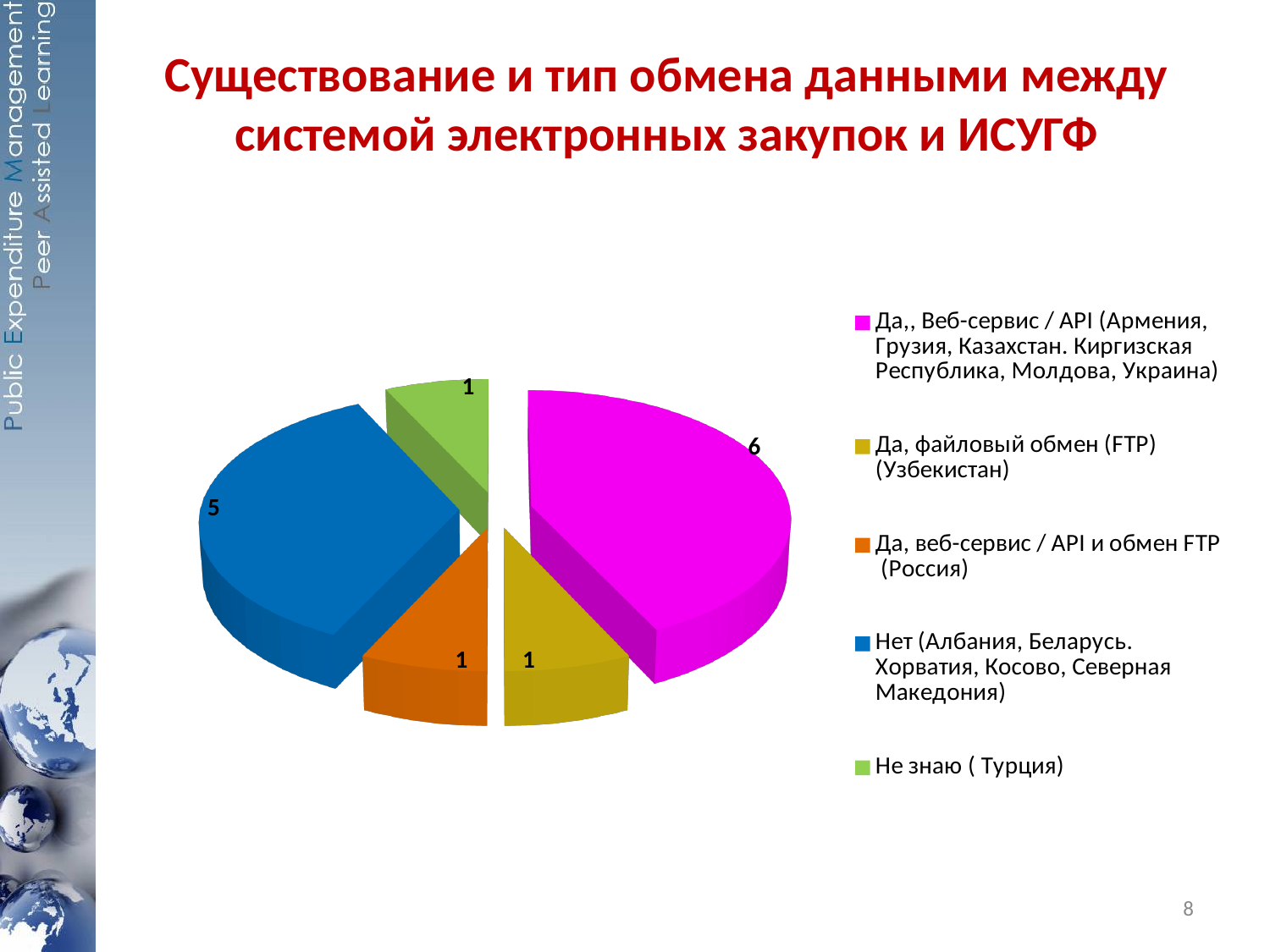
Which is larger: the value for "Нет" or the value for "Да, веб-сервис / API и обмен FTP (Россия)"? Нет What is the total of all the values shown on the pie chart? 14 What is the difference between the value for "Да,, Веб-сервис / API" and the value for "Нет"? 1 Which category has the largest slice of the pie? Да,, Веб-сервис / API (Армения, Грузия, Казахстан. Киргизская Республика, Молдова, Украина) What is the value for the slice "Не знаю ( Турция)"? 1 How many entries does the legend list? 5 What is the value for the slice "Да, файловый обмен (FTP) (Узбекистан)"? 1 What colour is the slice for "Нет (Албания, Беларусь. Хорватия, Косово, Северная Македония)"? Blue How many slices does the pie chart have? 5 What is the value for the slice "Да,, Веб-сервис / API (Армения, Грузия, Казахстан. Киргизская Республика, Молдова, Украина)"? 6 What kind of chart is shown on the slide? Pie chart What is the value for the slice "Нет (Албания, Беларусь. Хорватия, Косово, Северная Македония)"? 5